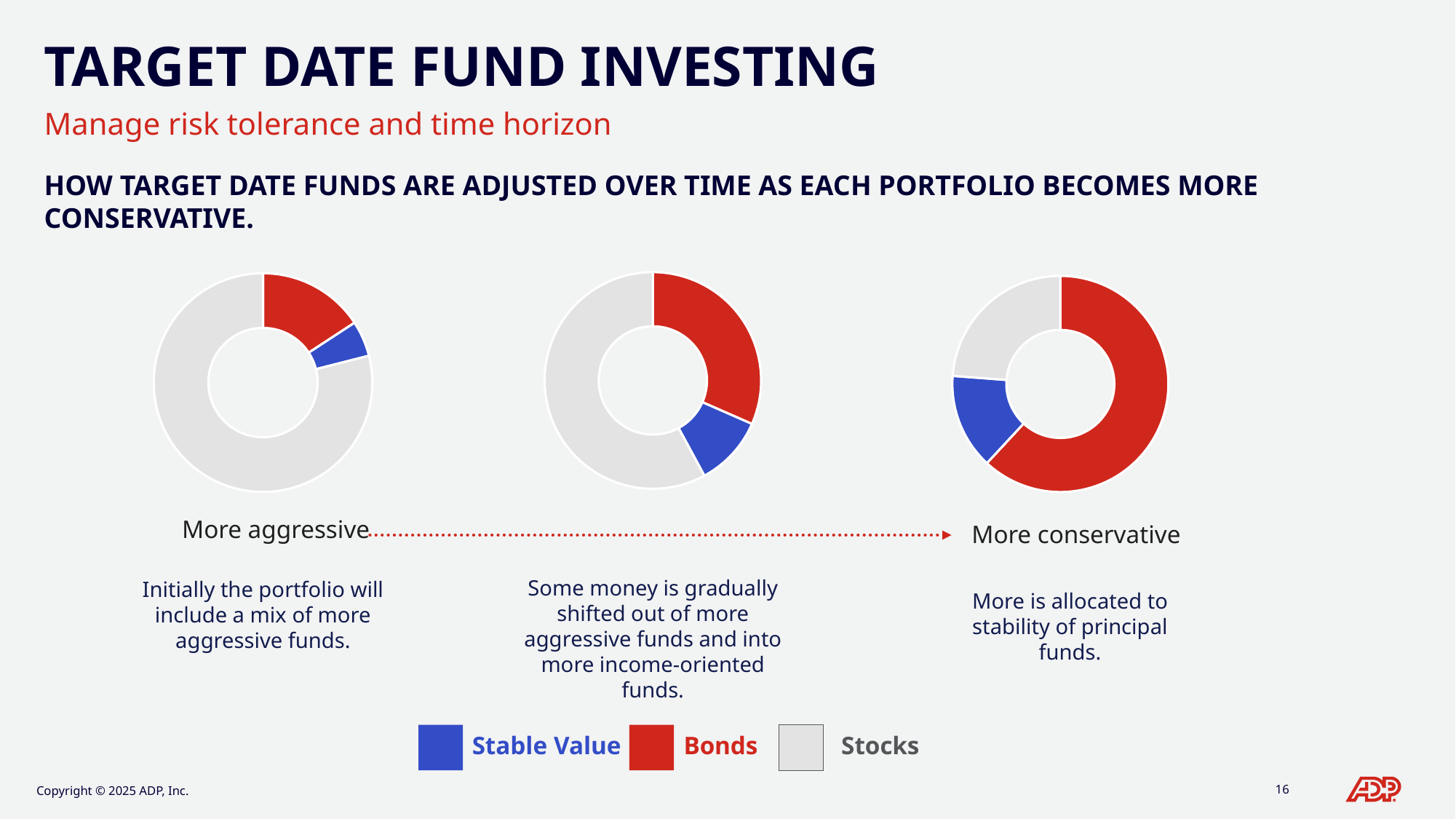
In the left-hand (More aggressive) donut chart, which category has the largest share? Stocks How many categories does the legend list for the charts? 3 Moving from the left-hand chart to the right-hand chart, does the Bonds share rise or fall? Rise In the right-hand (More conservative) donut chart, which is larger: the Bonds share or the Stocks share? Bonds How many slices does the left-hand (More aggressive) donut chart have? 3 In the middle donut chart, which category has the largest share? Stocks In the middle donut chart, which category has the smallest share? Stable Value In the left-hand (More aggressive) donut chart, which category has the smallest share? Stable Value Which colour represents Stable Value in the legend? Blue What kind of chart is used for the three portfolio illustrations on the slide? Donut (pie) chart In the right-hand (More conservative) donut chart, which category has the largest share? Bonds Moving from the left-hand chart to the right-hand chart, does the Stocks share rise or fall? Fall